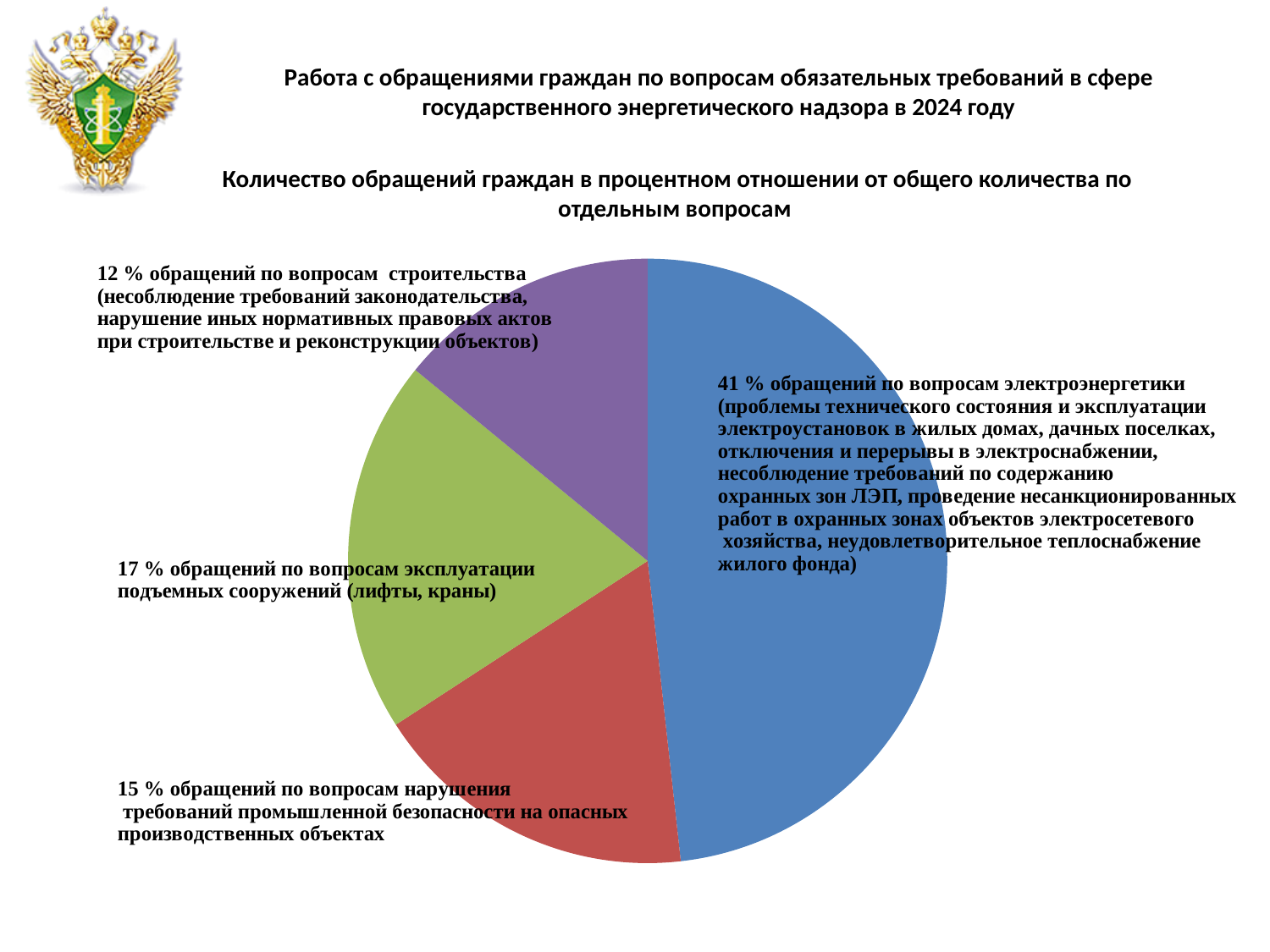
What percentage of appeals concerned the operation of lifting structures (lifts, cranes)? 17 % Which is larger: the share of appeals on lifting structures or the share on industrial safety at hazardous production facilities? lifting structures (17 %) Which category accounts for the largest share of appeals? обращения по вопросам электроэнергетики Which category accounts for the smallest share of appeals? обращения по вопросам строительства What percentage of appeals concerned violations of industrial safety requirements at hazardous production facilities? 15 % What colour is the slice representing appeals on construction issues? purple What kind of chart is shown on the slide? pie chart By how many percentage points does the share of appeals on electric power issues exceed the share on lifting structures? 24 What colour is the slice representing appeals on electric power issues? blue What percentage of appeals concerned construction issues (вопросы строительства)? 12 % How many slices does the pie chart have? 4 What percentage of citizens' appeals concerned electric power issues (вопросы электроэнергетики)? 41 %